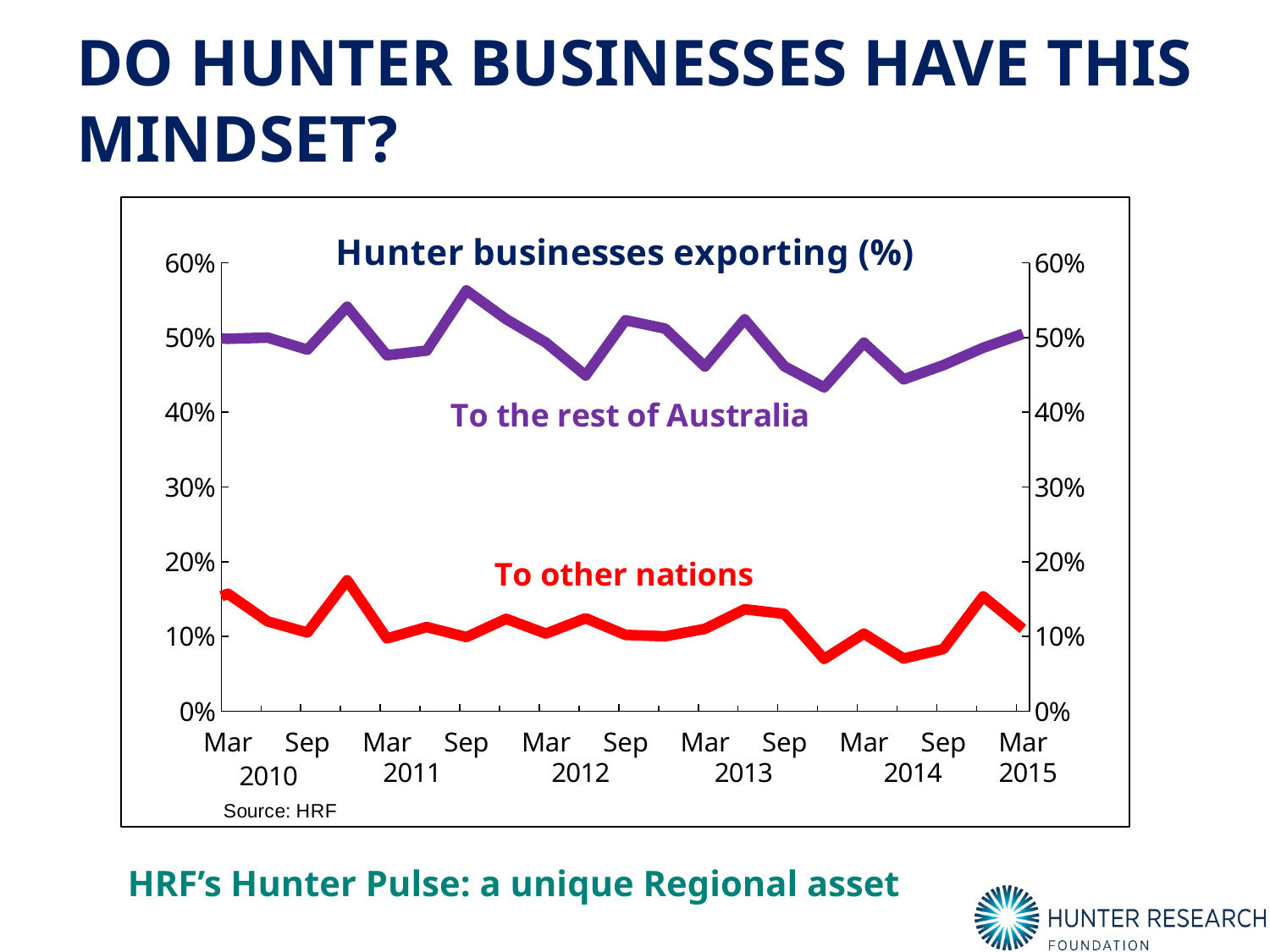
What kind of chart is shown on the slide? line chart What colour is the line for 'To other nations'? red What is the title of the chart? Hunter businesses exporting (%) Is the value for 'To other nations' in Sep 2013 greater or less than 20%? less Is the value for 'To the rest of Australia' in Mar 2010 greater or less than 40%? greater How many years are labelled on the x axis? 6 How many series are plotted on the chart? 2 Is the value for 'To other nations' in Mar 2010 greater or less than 10%? greater Which series has the higher value in Mar 2015, 'To the rest of Australia' or 'To other nations'? To the rest of Australia